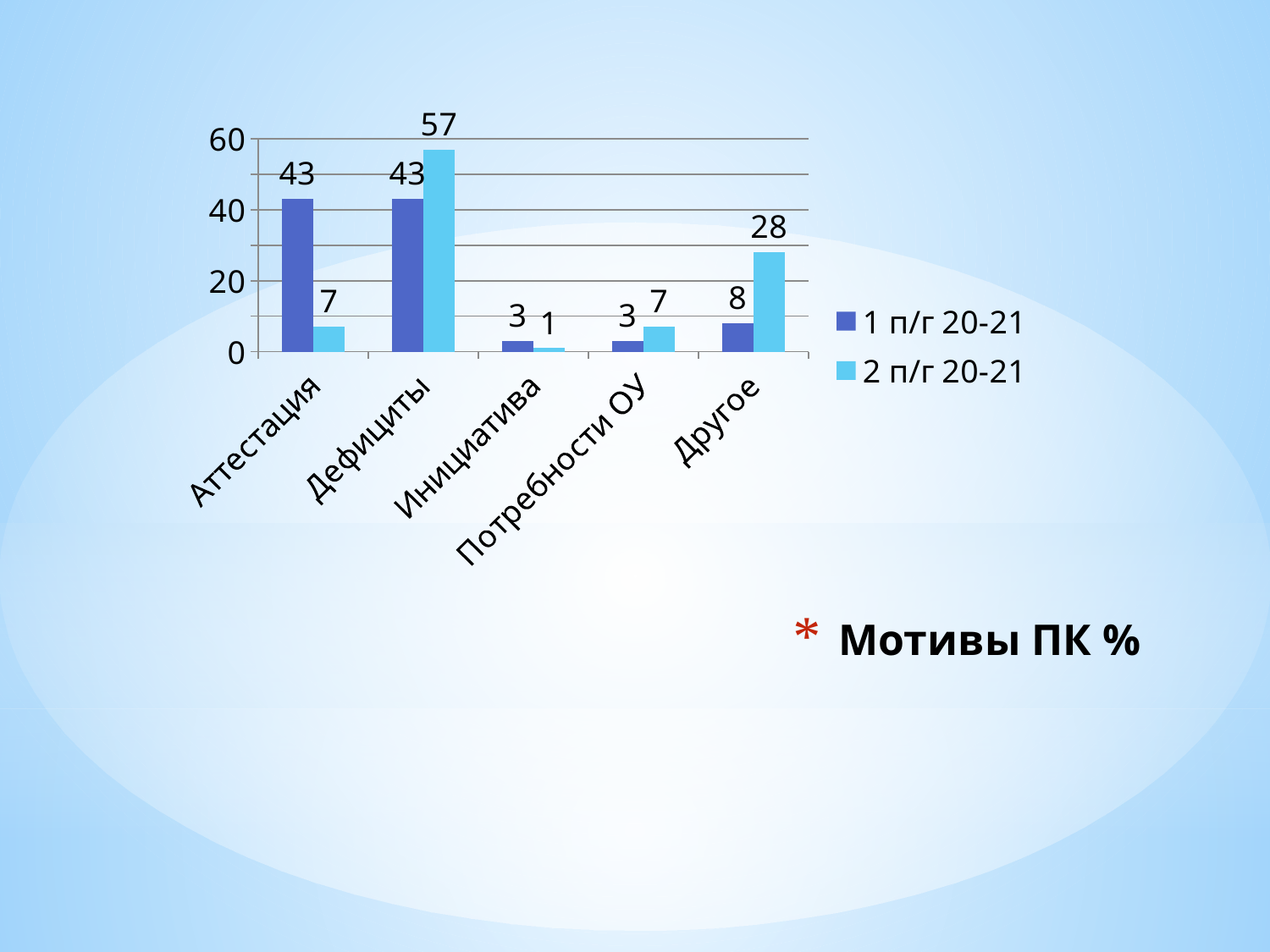
How many series does the legend list? 2 What is the value for Дефициты in the 2 п/г 20-21 series? 57 Which is larger for Другое: the 1 п/г 20-21 value or the 2 п/г 20-21 value? 2 п/г 20-21 What is the difference between the 1 п/г 20-21 and 2 п/г 20-21 values for Аттестация? 36 What is the difference between the 2 п/г 20-21 and 1 п/г 20-21 values for Дефициты? 14 What is the value for Аттестация in the 1 п/г 20-21 series? 43 Which category has the lowest value in the 2 п/г 20-21 series? Инициатива Which category has the highest value in the 2 п/г 20-21 series? Дефициты What is the value for Инициатива in the 2 п/г 20-21 series? 1 How many categories are shown on the x axis? 5 What kind of chart is shown on the slide? Bar chart What is the value for Другое in the 2 п/г 20-21 series? 28